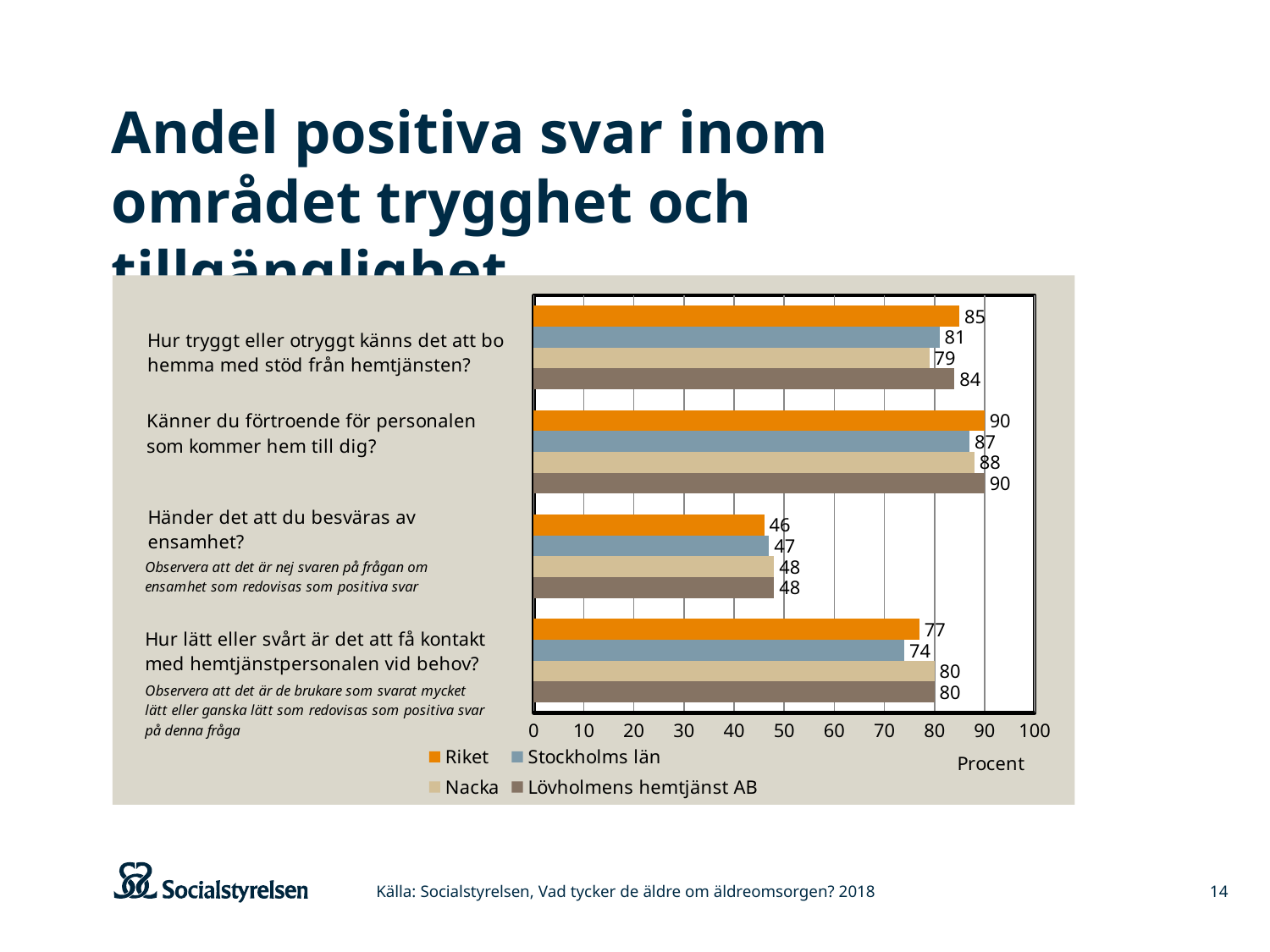
How many series does the legend list? 4 What label is shown on the horizontal axis of the chart? Procent Which is larger for Riket: the value for "Känner du förtroende för personalen som kommer hem till dig?" or the value for "Händer det att du besväras av ensamhet?"? Känner du förtroende för personalen som kommer hem till dig? Which series has the lowest value on the question "Hur tryggt eller otryggt känns det att bo hemma med stöd från hemtjänsten?"? Nacka What kind of chart is shown on the slide? Bar chart What is the difference between Riket and Stockholms län on the question "Hur tryggt eller otryggt känns det att bo hemma med stöd från hemtjänsten?"? 4 Which series has the lowest value on the question "Hur lätt eller svårt är det att få kontakt med hemtjänstpersonalen vid behov?"? Stockholms län How many question categories are shown on the chart? 4 What is the value for Lövholmens hemtjänst AB on the question "Händer det att du besväras av ensamhet?"? 48 What is the value for Riket on the question "Hur tryggt eller otryggt känns det att bo hemma med stöd från hemtjänsten?"? 85 What is the value for Stockholms län on the question "Hur lätt eller svårt är det att få kontakt med hemtjänstpersonalen vid behov?"? 74 What is the value for Nacka on the question "Känner du förtroende för personalen som kommer hem till dig?"? 88